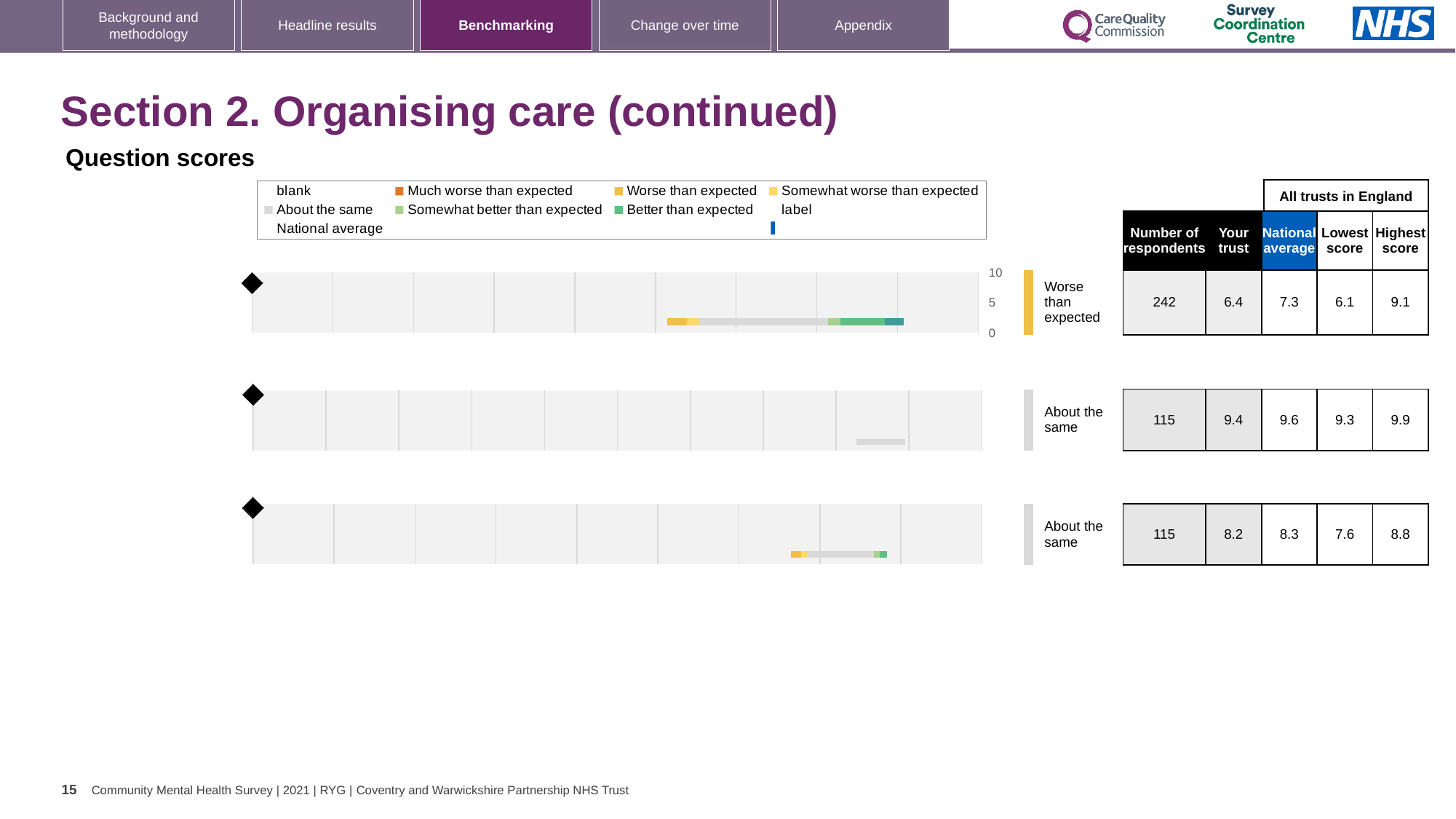
What benchmark rating label is shown next to the top chart? Worse than expected For the top chart, what is the highest score among all trusts in England? 9.1 For the bottom chart, what is the national average score shown in the table? 8.3 For the top chart, what is the national average score shown in the table? 7.3 Which of the three charts has the highest 'Your trust' score in the table? The middle chart For the top chart, what is the 'Your trust' score shown in the table? 6.4 For the bottom chart, what is the difference between the highest score and the lowest score in the table? 1.2 For the middle chart, what is the 'Your trust' score shown in the table? 9.4 For the top chart, how many respondents are shown in the table? 242 For the middle chart, what is the lowest score among all trusts in England? 9.3 For the top chart, which is larger: the 'Your trust' score or the national average? National average What kind of chart is used for the benchmarking rows on this slide? Bar chart